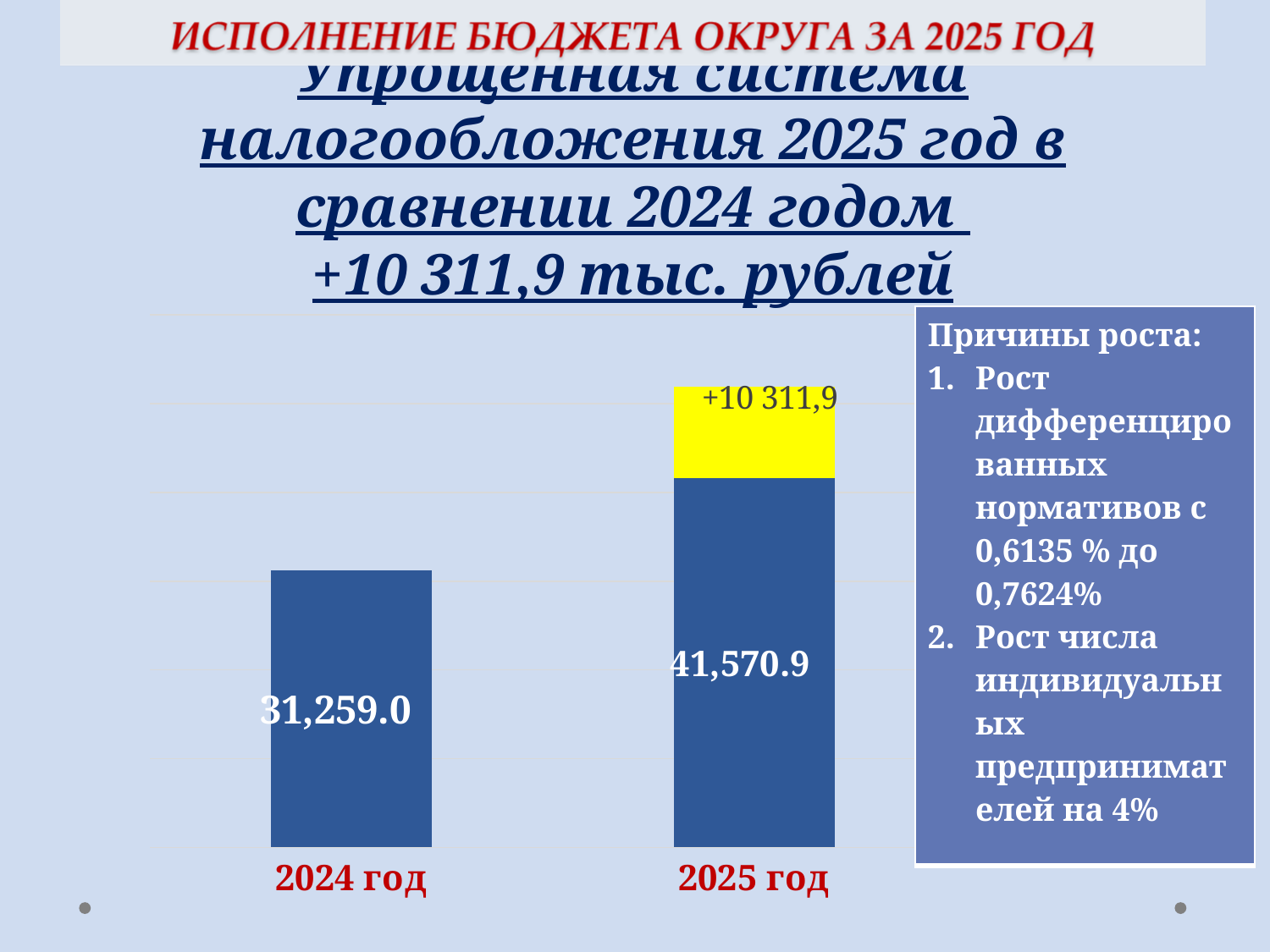
What colour is the segment representing the increase on the 2025 год bar? yellow Do the values rise or fall from 2024 год to 2025 год? rise What increase in thousand rubles is stated in the chart title for 2025 compared with 2024? +10 311,9 тыс. рублей What kind of chart is shown on the slide? bar chart What is the value shown for 2024 год? 31,259.0 Which year has the lower value? 2024 год Which year has the higher value? 2025 год What is the difference between the 2025 год value and the 2024 год value? 10,311.9 How many categories (years) are shown on the chart? 2 Is the value for 2025 год larger or smaller than the value for 2024 год? larger What label is printed on the yellow segment of the 2025 год bar? +10 311,9 What is the value shown for 2025 год? 41,570.9